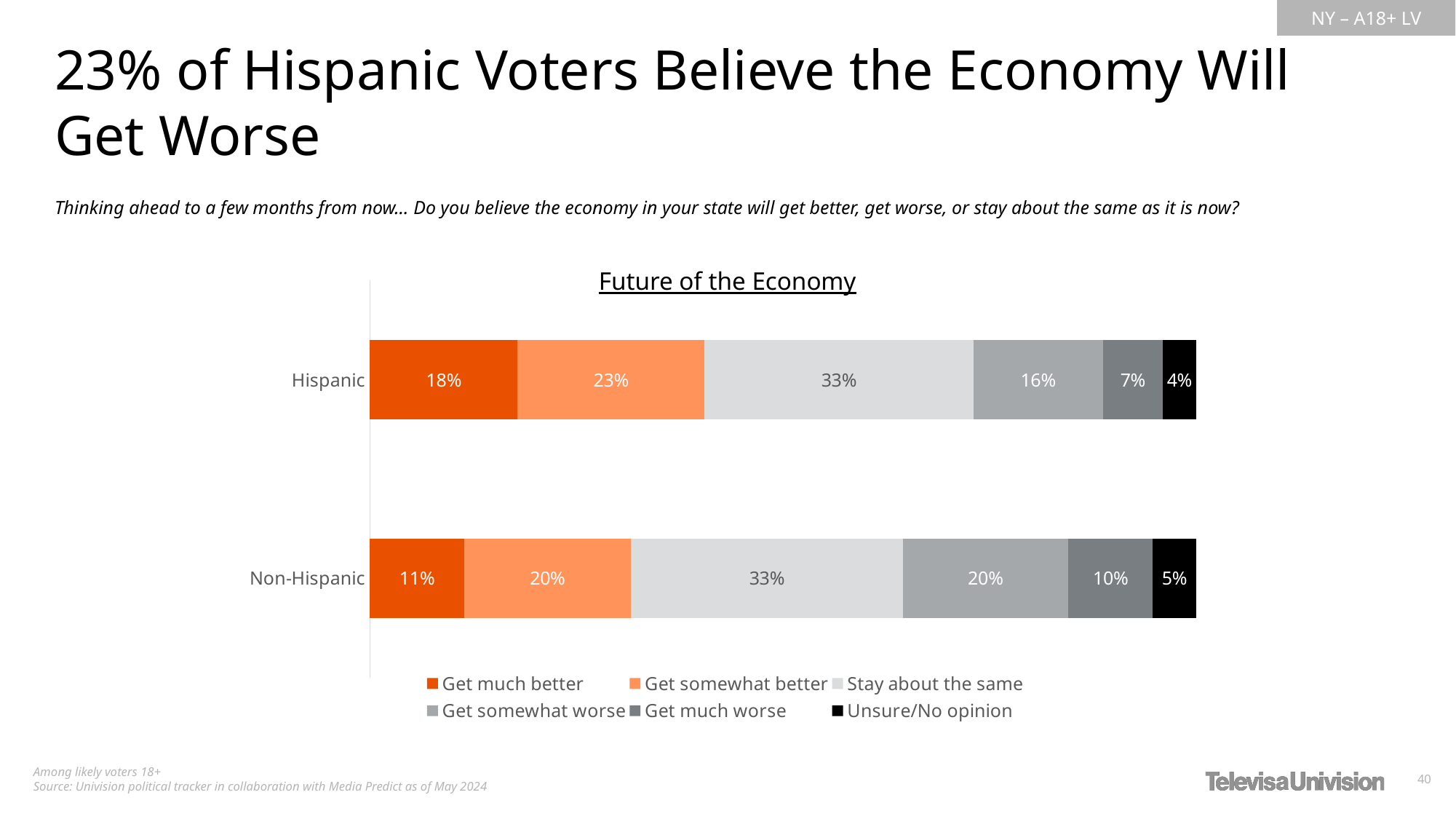
Which response category has the highest share among Hispanic voters? Stay about the same How many groups (categories) are shown on the chart? 2 What type of chart is shown on the slide? Stacked bar chart What is the title of the chart? Future of the Economy What percentage of Non-Hispanic voters say the economy will get much better? 11% What percentage of Hispanic voters say the economy will get much worse? 7% What percentage of Non-Hispanic voters are unsure or have no opinion? 5% Which group has a larger share saying the economy will get somewhat worse, Hispanic or Non-Hispanic? Non-Hispanic What is the difference between the Hispanic and Non-Hispanic shares for 'Get much better'? 7 percentage points How many series does the legend list? 6 What percentage of Hispanic voters say the economy will get somewhat better? 23% Which response category has the lowest share among Non-Hispanic voters? Unsure/No opinion